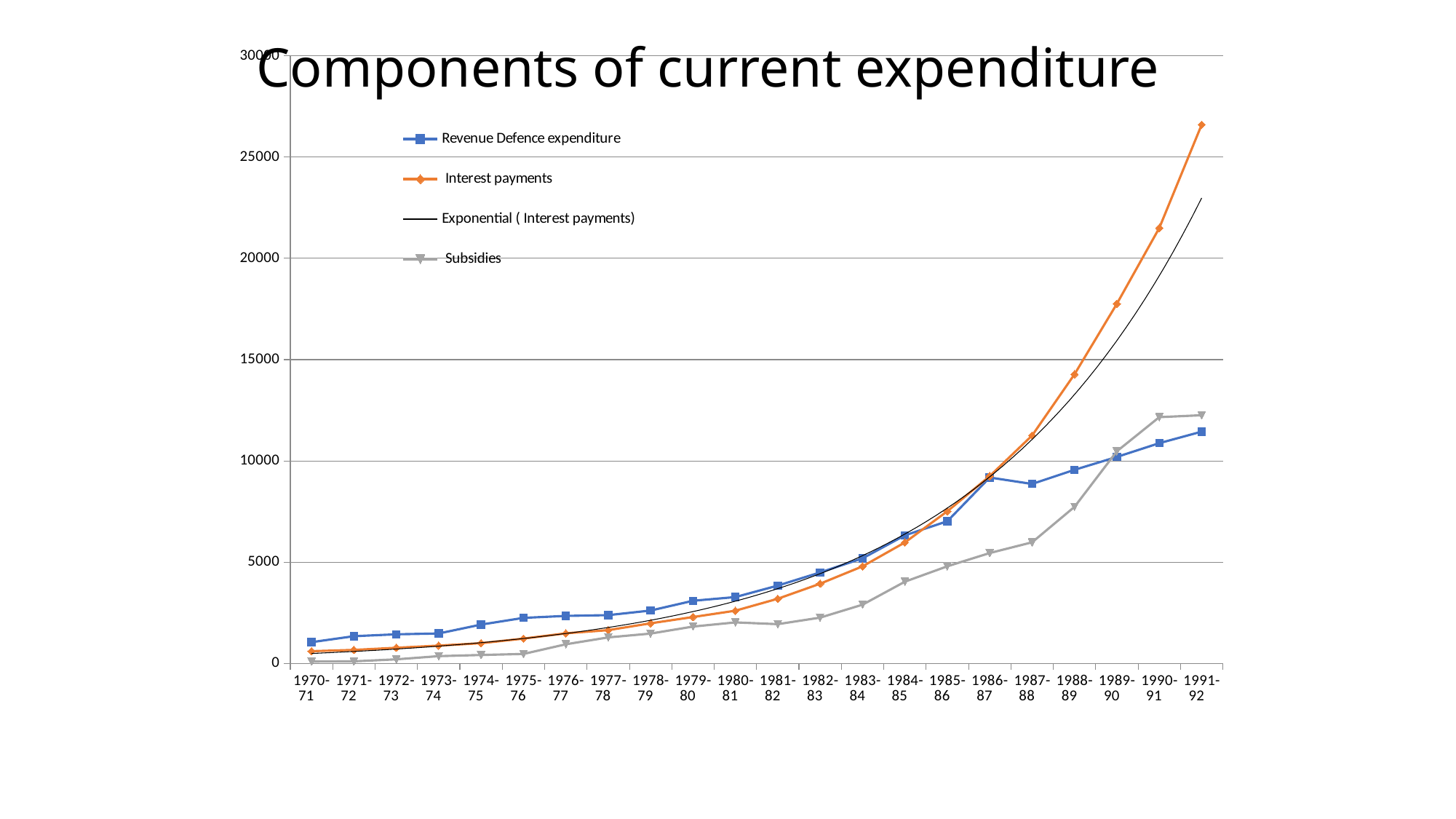
How many series does the legend list? 4 Is the value of Revenue Defence expenditure in 1991-92 greater or less than 15000? less In which year do Interest payments reach their highest value? 1991-92 Which series has the highest value in 1991-92? Interest payments Is the value of Interest payments in 1991-92 greater or less than 25000? greater What is the title of the chart? Components of current expenditure Do Interest payments generally rise or fall from 1970-71 to 1991-92? Rise What type of chart is shown on the slide? Line chart How many fiscal years are shown on the x axis? 22 In 1987-88, which is larger: Revenue Defence expenditure or Subsidies? Revenue Defence expenditure Is the value of Interest payments in 1989-90 greater or less than 15000? greater Which series has the lowest value in 1970-71? Subsidies